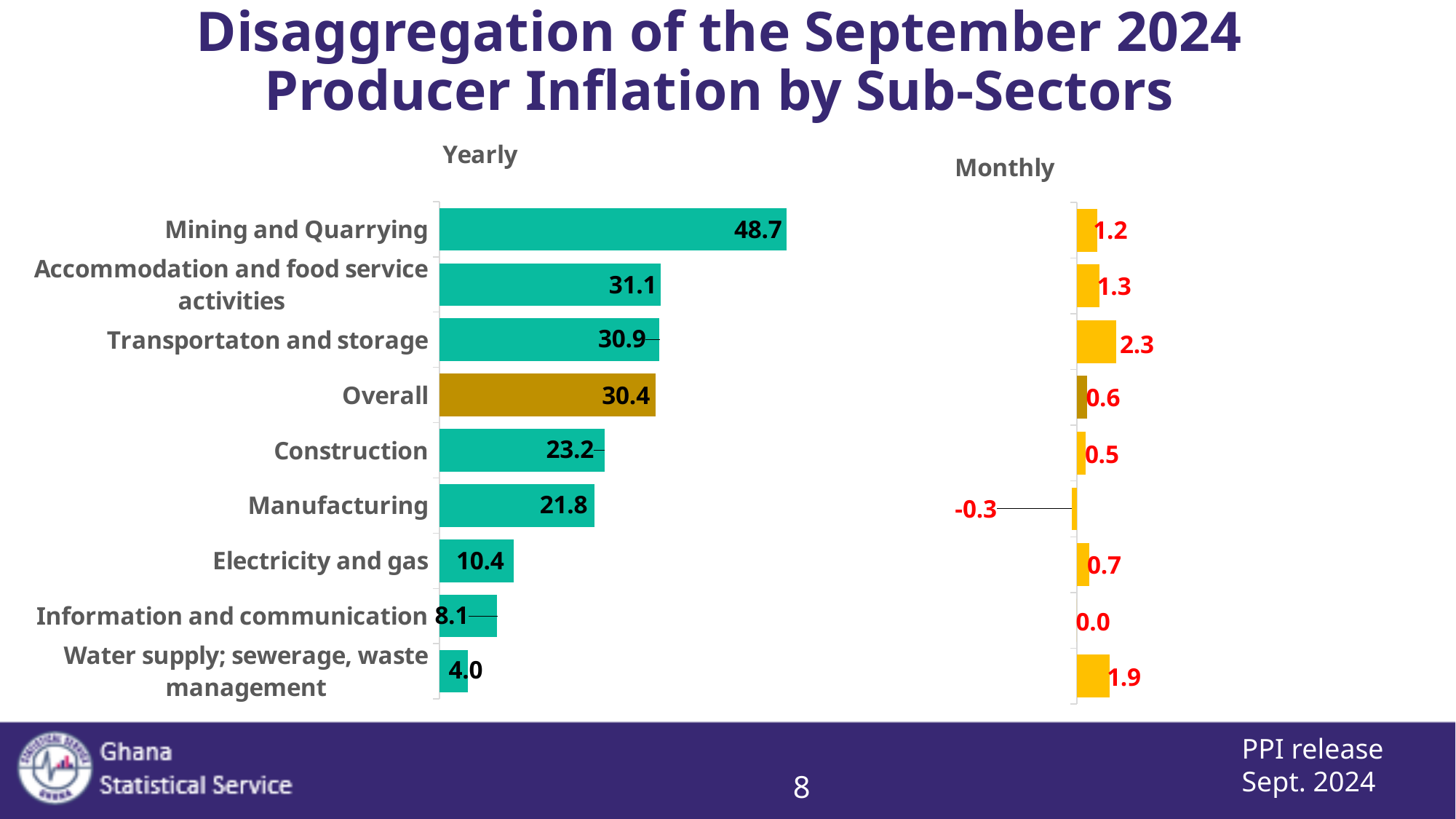
In the Monthly chart, what is the difference between Water supply; sewerage, waste management and Overall? 1.3 In the Yearly chart, what is the value for Mining and Quarrying? 48.7 In the Yearly chart, which is larger: Construction or Electricity and gas? Construction In the Yearly chart, what is the difference between Mining and Quarrying and Accommodation and food service activities? 17.6 How many categories are shown in the Yearly chart? 9 In the Monthly chart, what is the value for Manufacturing? -0.3 In the Yearly chart, which category has the lowest value? Water supply; sewerage, waste management In the Monthly chart, what is the value for Information and communication? 0.0 In the Yearly chart, what is the value for Overall? 30.4 In the Monthly chart, what is the value for Transportaton and storage? 2.3 What kind of chart is the Yearly chart? Bar chart In the Monthly chart, which category has the highest value? Transportaton and storage